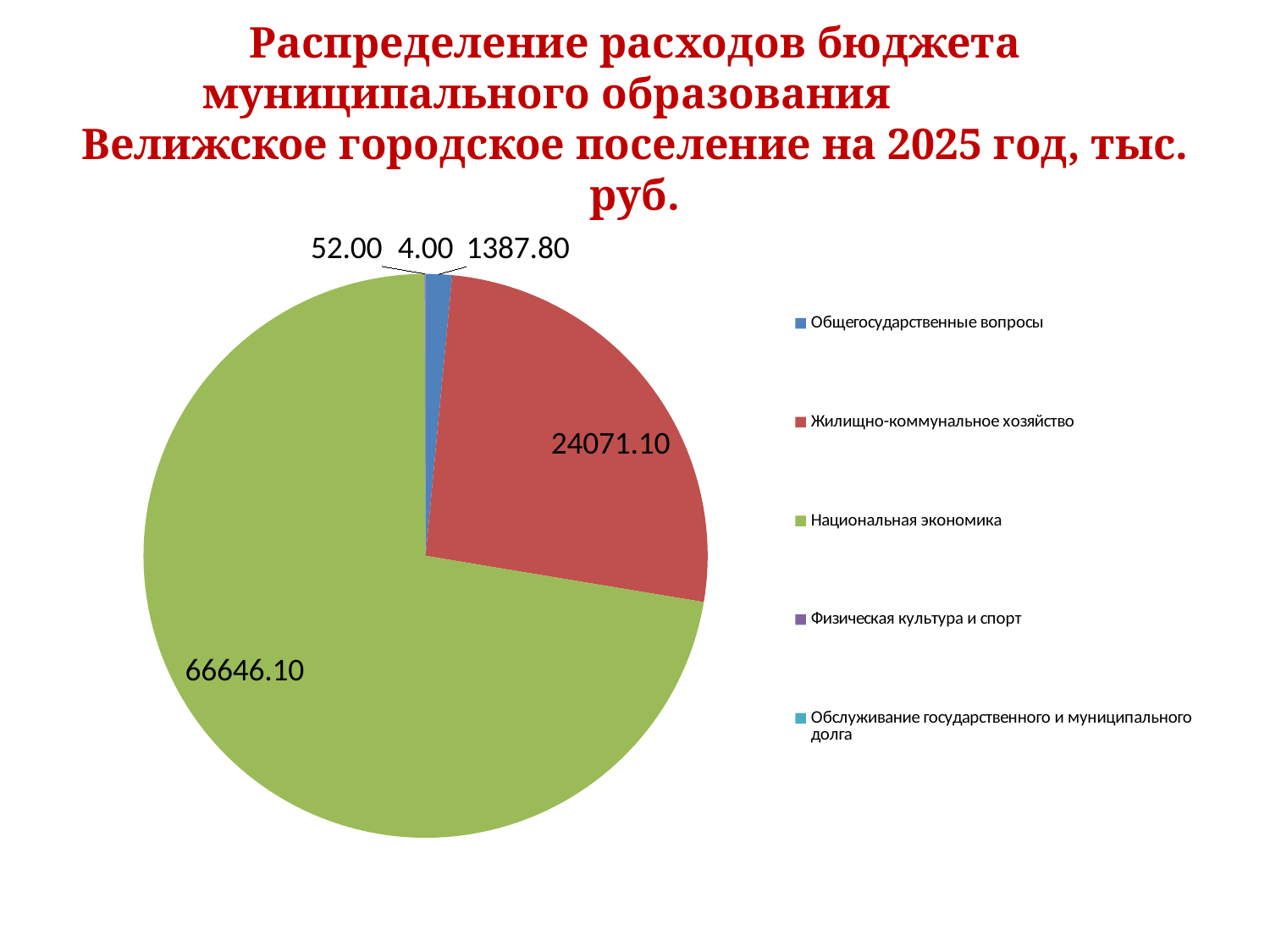
Which is larger: Жилищно-коммунальное хозяйство or Общегосударственные вопросы? Жилищно-коммунальное хозяйство What is the value for Национальная экономика? 66646.10 How many categories does the legend of the pie chart list? 5 What is the smallest data label shown on the pie chart? 4.00 What is the value for Жилищно-коммунальное хозяйство? 24071.10 Which category has the largest slice of the pie? Национальная экономика What type of chart is shown on the slide? pie chart What is the value for Общегосударственные вопросы? 1387.80 For which year does the chart title say the budget expenditures are distributed? 2025 What is the total of all values shown on the pie chart? 92161.00 What is the difference between the values for Национальная экономика and Жилищно-коммунальное хозяйство? 42575.00 What colour is the slice for Национальная экономика? green